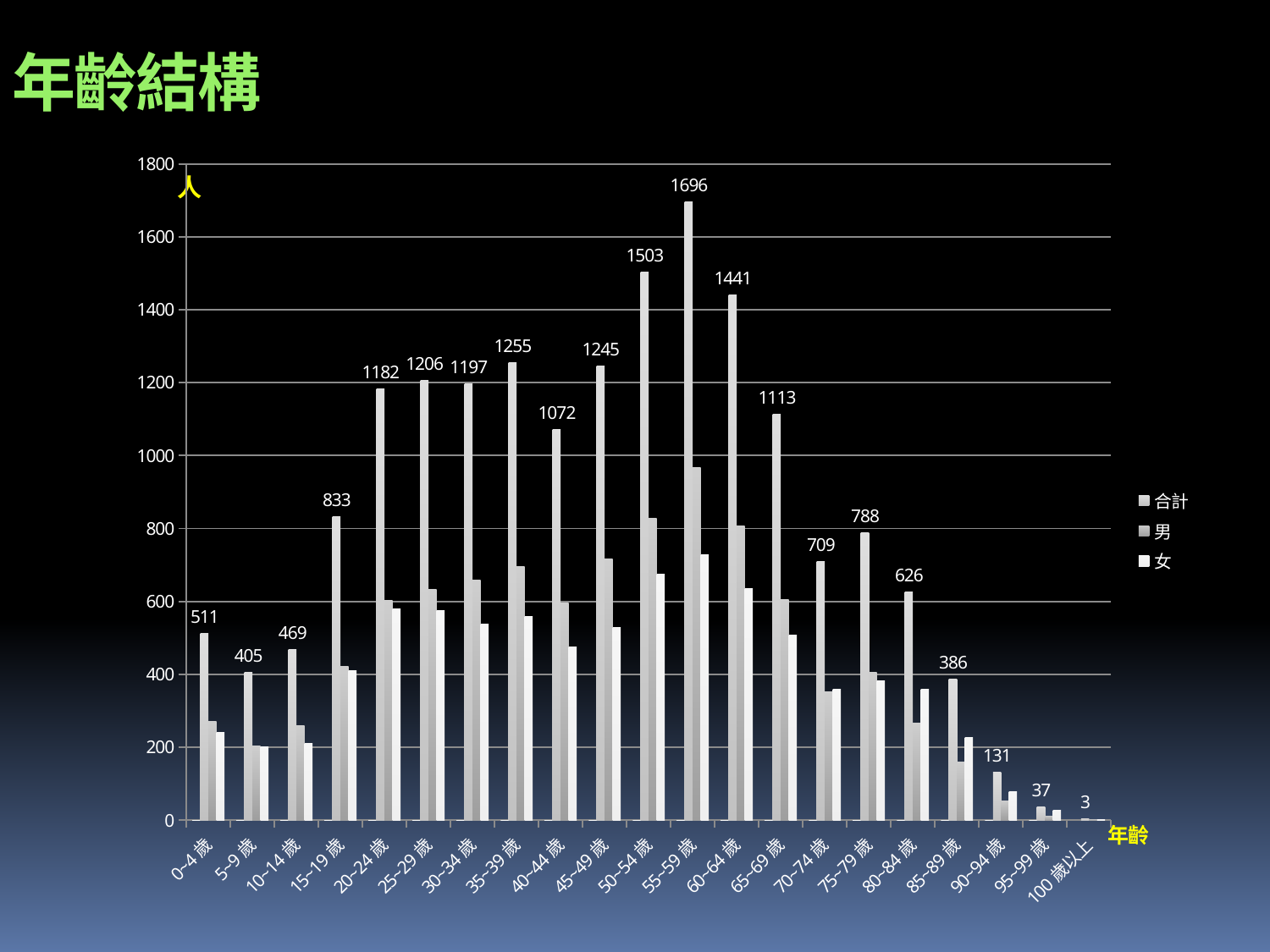
What is the 合計 value for the 0~4歲 age group? 511 What is the 合計 value for the 55~59歲 age group? 1696 Which age group has the highest 合計 value? 55~59歲 Which age group has the lowest 合計 value? 100歲以上 Is the 男 value for 55~59歲 greater or less than 800? greater Is the 女 value for 0~4歲 greater or less than 400? less What is the difference between the 合計 values for 50~54歲 and 45~49歲? 258 What kind of chart is shown on the slide? Bar chart How many age groups are shown on the x axis? 21 What is the difference between the 合計 values for 60~64歲 and 65~69歲? 328 How many series does the legend list? 3 Which has a larger 合計 value, 25~29歲 or 30~34歲? 25~29歲